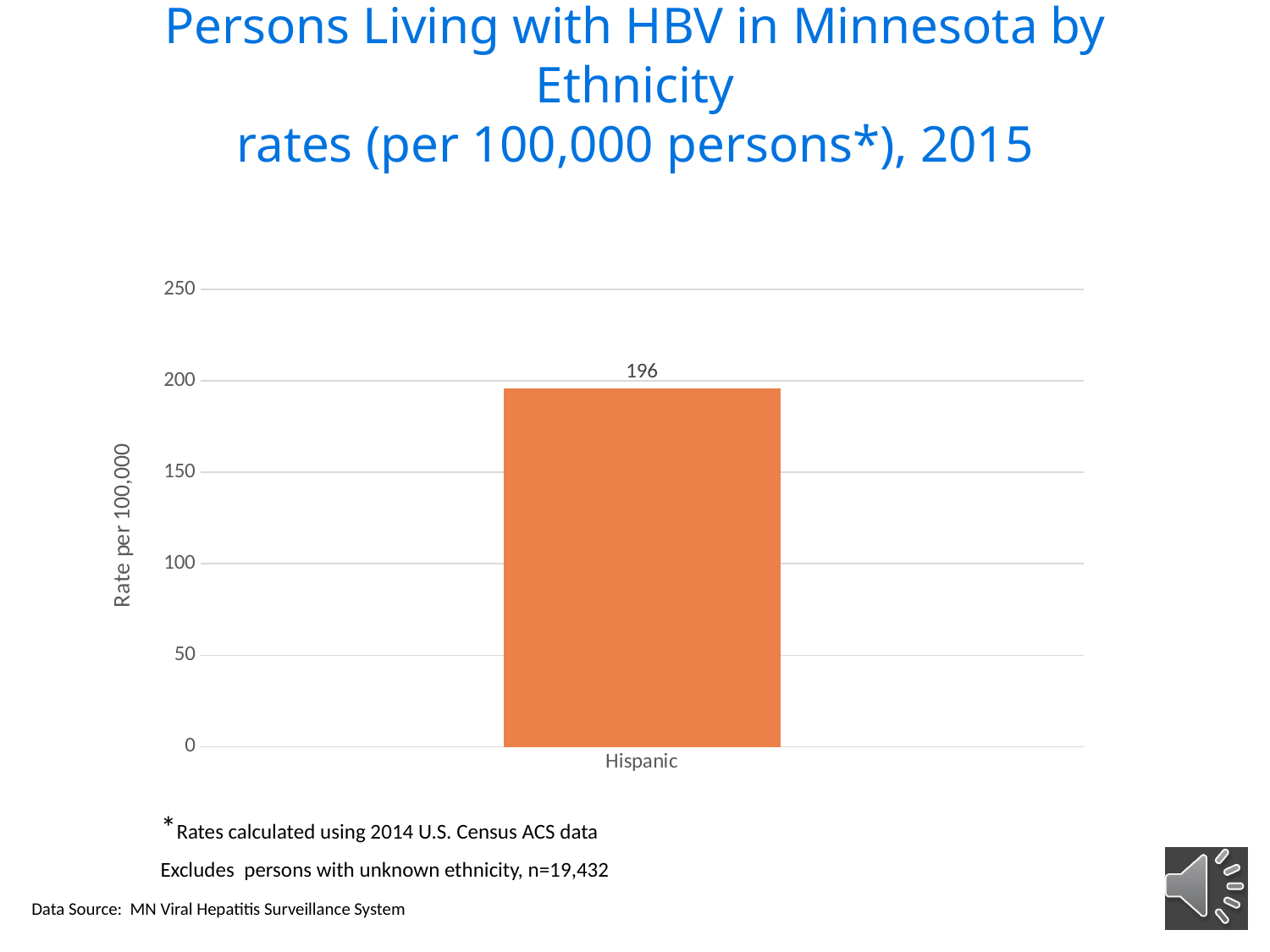
What is the y-axis title of the chart? Rate per 100,000 Is the value for Hispanic greater or less than 200? less What is the rate per 100,000 for Hispanic persons living with HBV in Minnesota in 2015? 196 Is the value for Hispanic greater or less than 150? greater How many categories are plotted on the chart? 1 What is the highest value shown on the y axis? 250 What is the label of the only category on the x axis? Hispanic What kind of chart is shown on the slide? bar chart